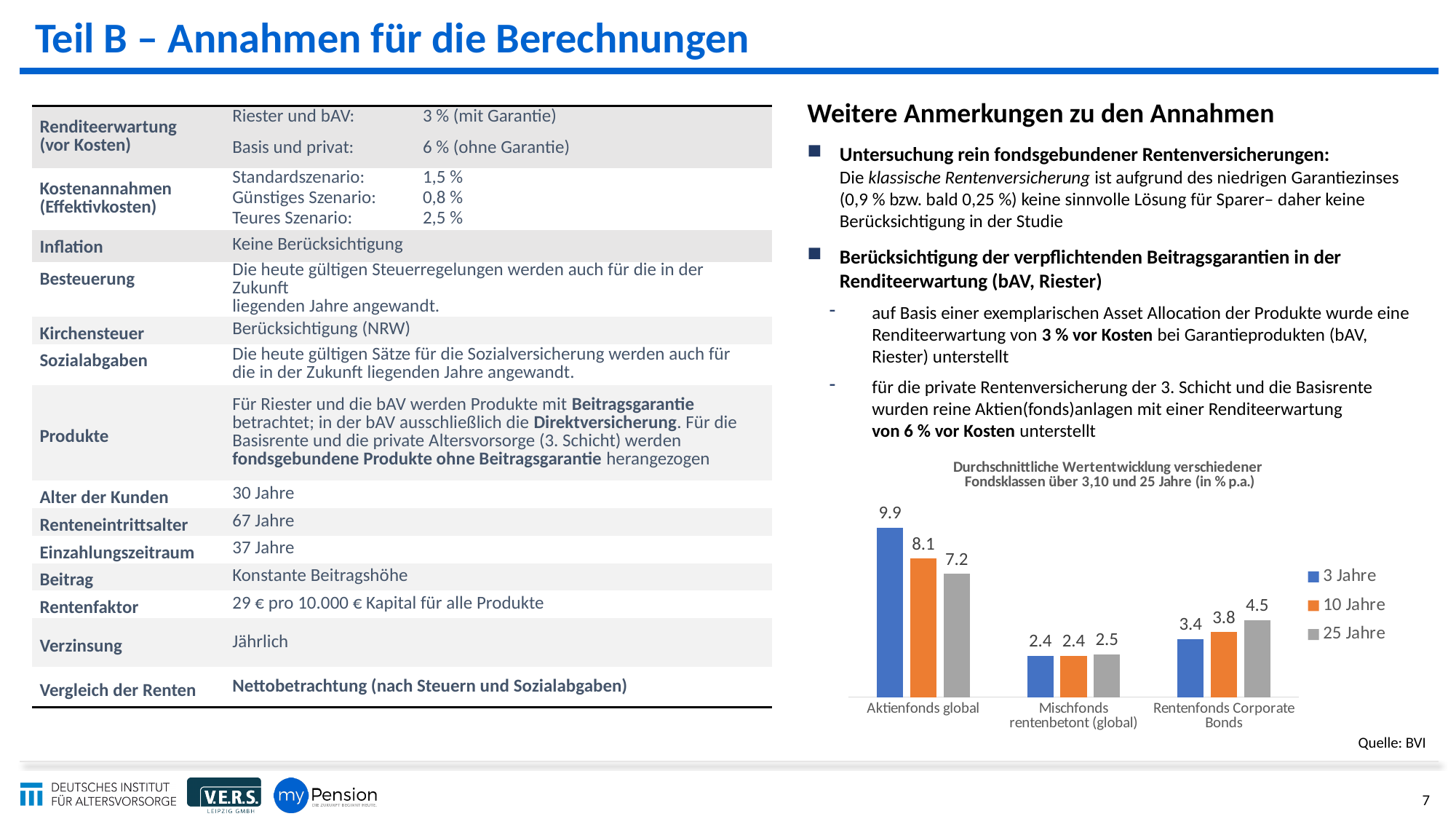
Do the values for Aktienfonds global rise or fall from 3 Jahre to 25 Jahre? Fall Which category has the lowest 25 Jahre value? Mischfonds rentenbetont (global) How many fund categories are shown on the x axis? 3 Which colour represents the 10 Jahre series in the chart? Orange What is the difference between the 3 Jahre and 25 Jahre values for Aktienfonds global? 2.7 What is the 25 Jahre value for Rentenfonds Corporate Bonds? 4.5 What is the 3 Jahre value for Aktienfonds global? 9.9 How many series does the legend list? 3 Which is larger for Rentenfonds Corporate Bonds: the 3 Jahre value or the 25 Jahre value? 25 Jahre What kind of chart is shown on the slide? Bar chart What is the 10 Jahre value for Mischfonds rentenbetont (global)? 2.4 Which category has the highest 3 Jahre value? Aktienfonds global